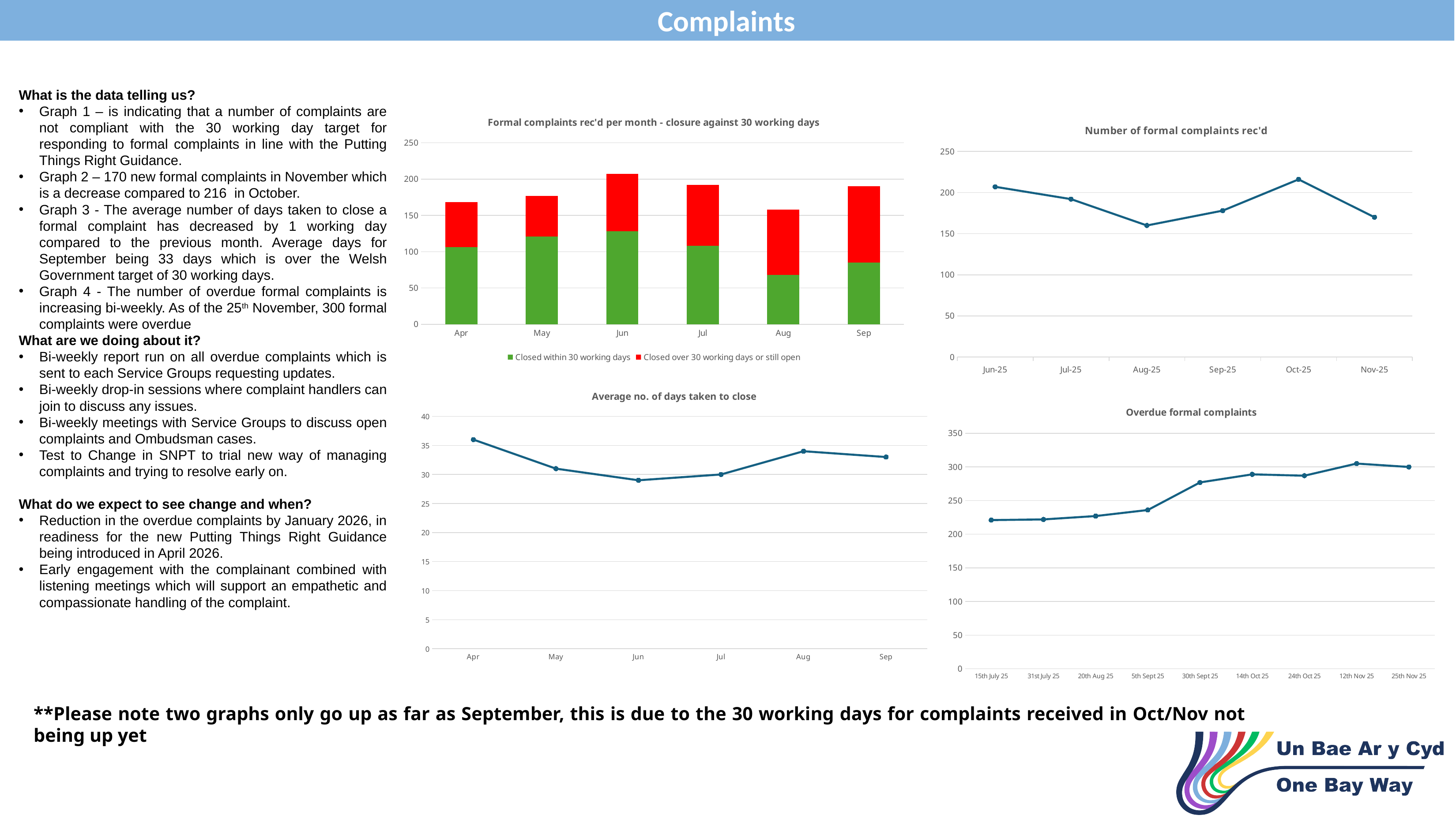
How many series does the legend list in the 'Formal complaints rec'd per month - closure against 30 working days' chart? 2 How many data points are plotted in the 'Overdue formal complaints' chart? 9 In the 'Formal complaints rec'd per month - closure against 30 working days' chart, which month has the smallest 'Closed within 30 working days' segment? Aug In the 'Overdue formal complaints' chart, do the values generally rise or fall from 15th July 25 to 25th Nov 25? rise In the 'Formal complaints rec'd per month - closure against 30 working days' chart, is the 'Closed within 30 working days' value for Aug greater or less than 100? less In the 'Number of formal complaints rec'd' chart, is the value for Nov-25 greater or less than 200? less What type of chart is 'Formal complaints rec'd per month - closure against 30 working days'? stacked bar chart In the 'Number of formal complaints rec'd' chart, which month has the lowest value? Aug-25 In the 'Formal complaints rec'd per month - closure against 30 working days' chart, which month has the tallest total bar? Jun In the 'Number of formal complaints rec'd' chart, which month has the highest value? Oct-25 In the 'Average no. of days taken to close' chart, which is larger, the value for Apr or the value for Jun? Apr In the 'Average no. of days taken to close' chart, which month has the highest value? Apr